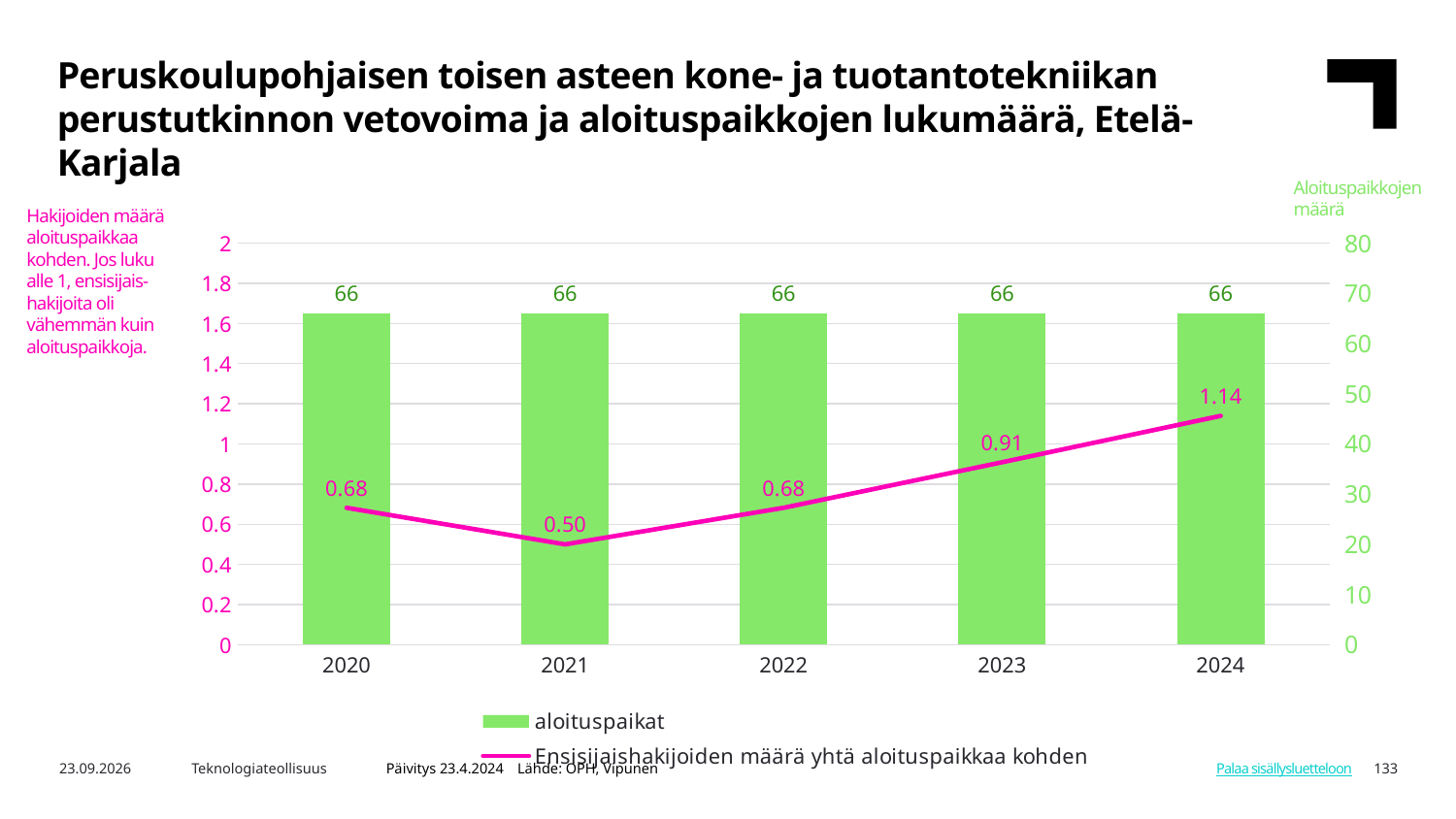
What kinds of chart are combined on this slide? A bar chart and a line chart Which year has a larger value for 'Ensisijaishakijoiden määrä yhtä aloituspaikkaa kohden', 2021 or 2023? 2023 What is the value of the line series 'Ensisijaishakijoiden määrä yhtä aloituspaikkaa kohden' for 2024? 1.14 In which year is the line series 'Ensisijaishakijoiden määrä yhtä aloituspaikkaa kohden' highest? 2024 In which year is the line series 'Ensisijaishakijoiden määrä yhtä aloituspaikkaa kohden' lowest? 2021 How many years are shown on the x axis of the chart? 5 How many 'aloituspaikat' are shown for 2022? 66 What colour are the 'aloituspaikat' bars in the chart? Green Does the line series 'Ensisijaishakijoiden määrä yhtä aloituspaikkaa kohden' rise or fall from 2021 to 2024? Rise What is the value of the line series 'Ensisijaishakijoiden määrä yhtä aloituspaikkaa kohden' for 2021? 0.50 How many series does the chart legend list? 2 What is the difference between the 2024 and 2023 values of the line series 'Ensisijaishakijoiden määrä yhtä aloituspaikkaa kohden'? 0.23